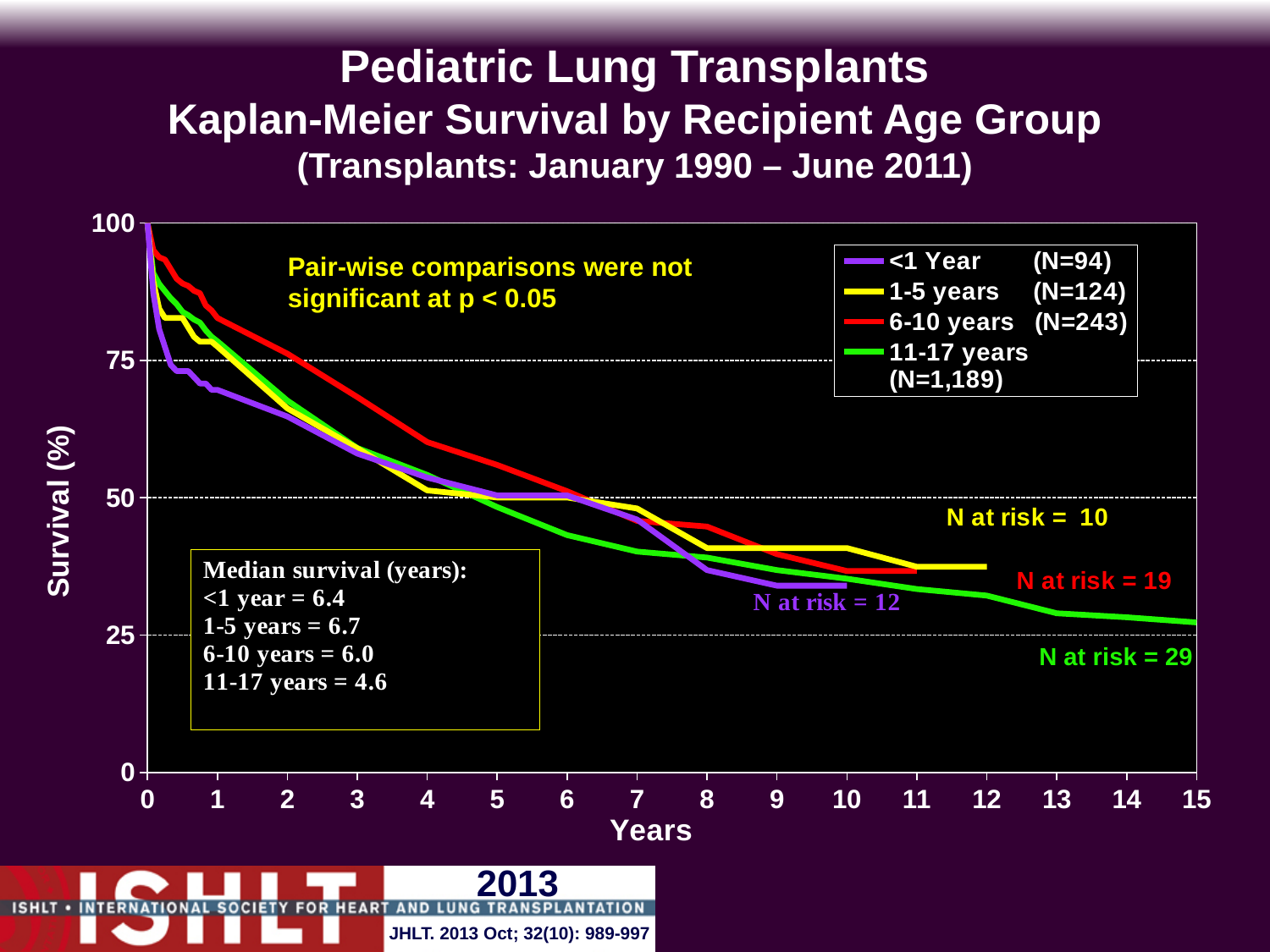
Which recipient age group has the highest median survival? 1-5 years Is the survival for the 11-17 years group at 15 years greater or less than 50? less What is the difference in median survival (years) between the 1-5 years group and the 11-17 years group? 2.1 What is the median survival in years for the 1-5 years age group? 6.7 How many series does the legend list? 4 What kind of chart is shown on the slide? line chart What is the number of patients (N) in the 11-17 years group according to the legend? N=1,189 Is the survival for the 6-10 years group at 1 year greater or less than 75? greater What is the median survival in years for the 11-17 years age group? 4.6 Do the survival curves rise or fall as years increase along the x axis? fall Which recipient age group has the lowest median survival? 11-17 years What is the N at risk shown for the 6-10 years (red) curve? 19